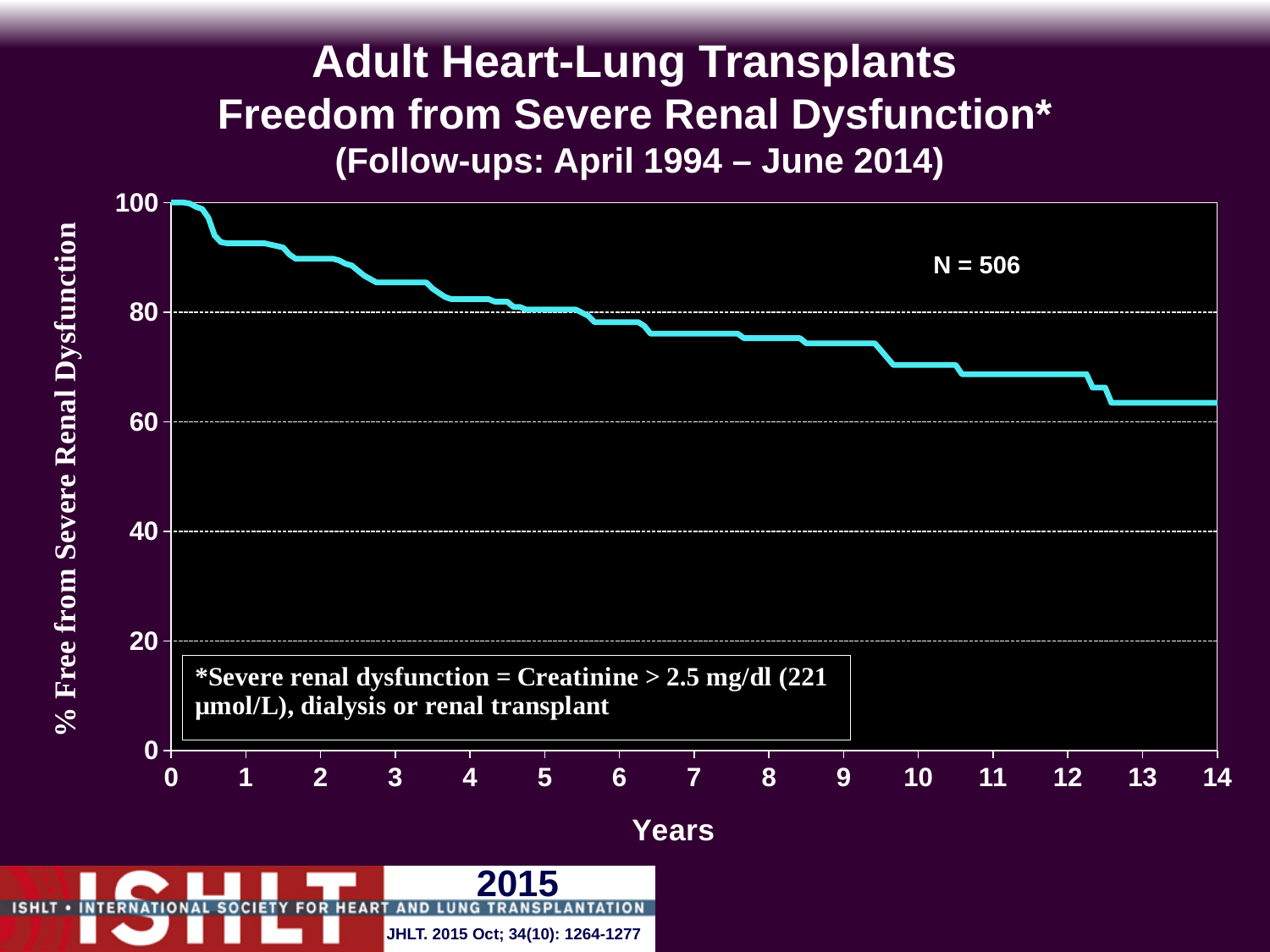
What is the sample size (N) shown on the chart? N = 506 What is the label of the x axis? Years Is the value at year 2 greater or less than 80? greater What kind of chart is shown on the slide? line chart Is the value at year 10 greater or less than 60? greater Is the value at year 7 greater or less than 80? less What is the value of the curve at year 0? 100 Does the percentage free from severe renal dysfunction rise or fall as years increase? fall Is the value at year 2 larger than the value at year 12? yes